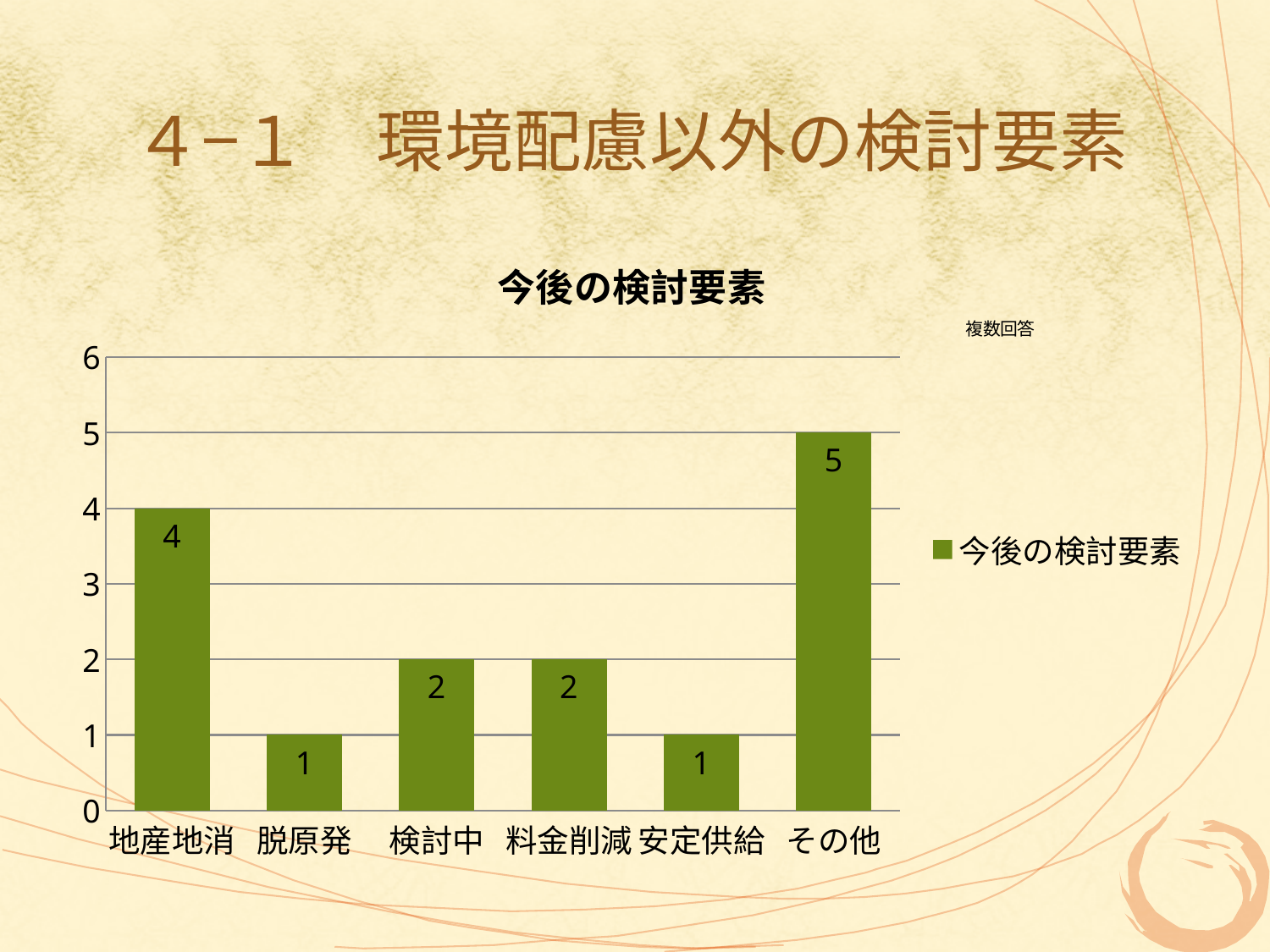
What is the difference between the values for 料金削減 and 安定供給? 1 How many series does the legend list? 1 What is the value for 安定供給? 1 What is the value for 地産地消? 4 What is the value for その他? 5 What kind of chart is shown? bar chart What is the difference between the values for その他 and 地産地消? 1 How many categories are shown on the x axis? 6 What is the title of the chart? 今後の検討要素 Which category has the highest value? その他 Is the value for その他 greater or less than 3? greater Which is larger, the value for 検討中 or the value for 脱原発? 検討中